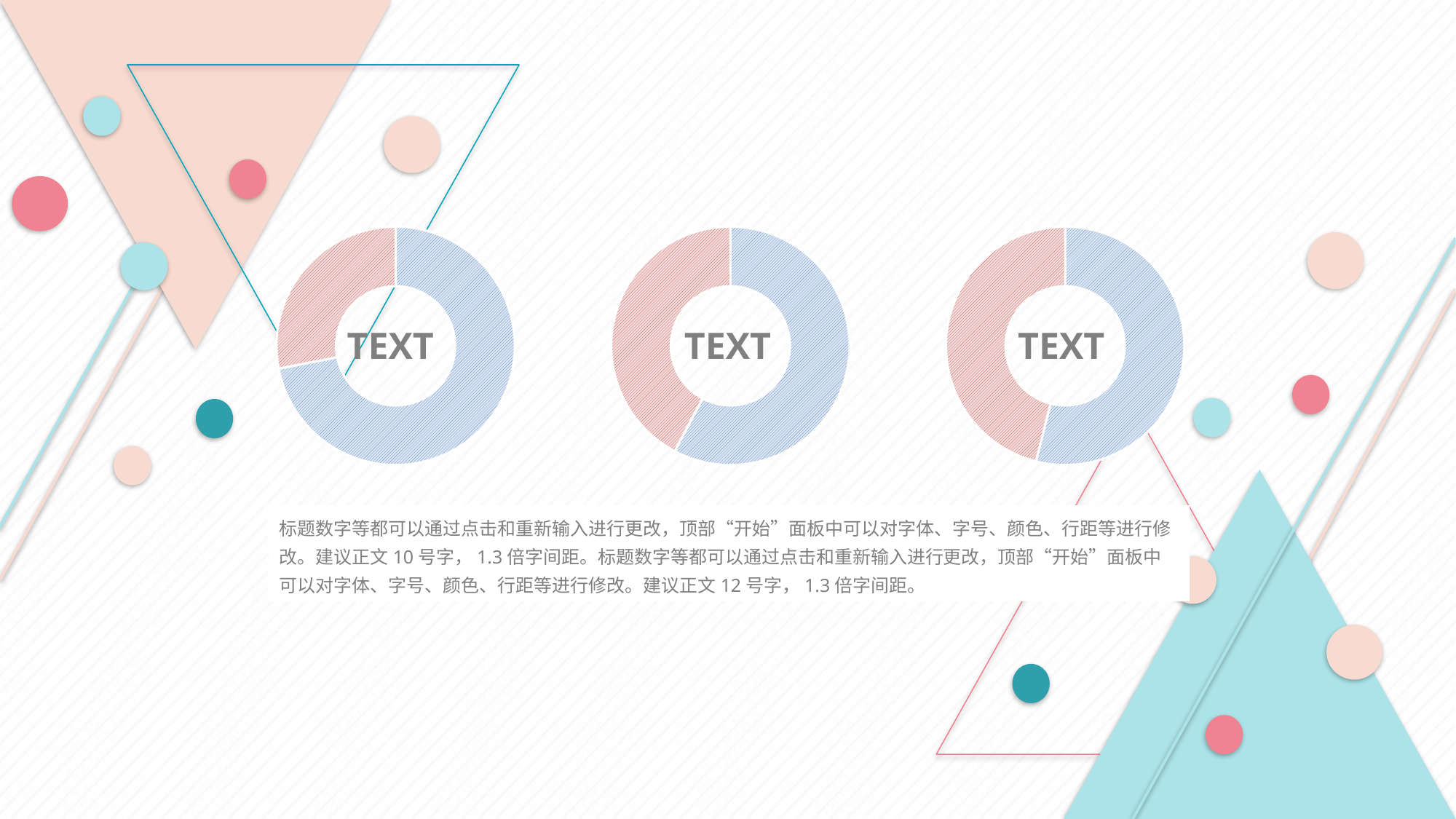
What word is printed in the centre of each doughnut chart? TEXT What kind of chart is the right chart on the slide? doughnut chart In the right chart, which slice is larger, the pink one or the blue one? blue In the middle chart, how many slices does the ring contain? 2 Does the left chart display a legend? No In the middle chart, which slice is larger, the pink one or the blue one? blue What kind of chart is the left chart on the slide? doughnut chart What kind of chart is the middle chart on the slide? doughnut chart How many charts are shown on the slide? 3 In the left chart, how many slices does the ring contain? 2 In the left chart, which slice is larger, the pink one or the blue one? blue